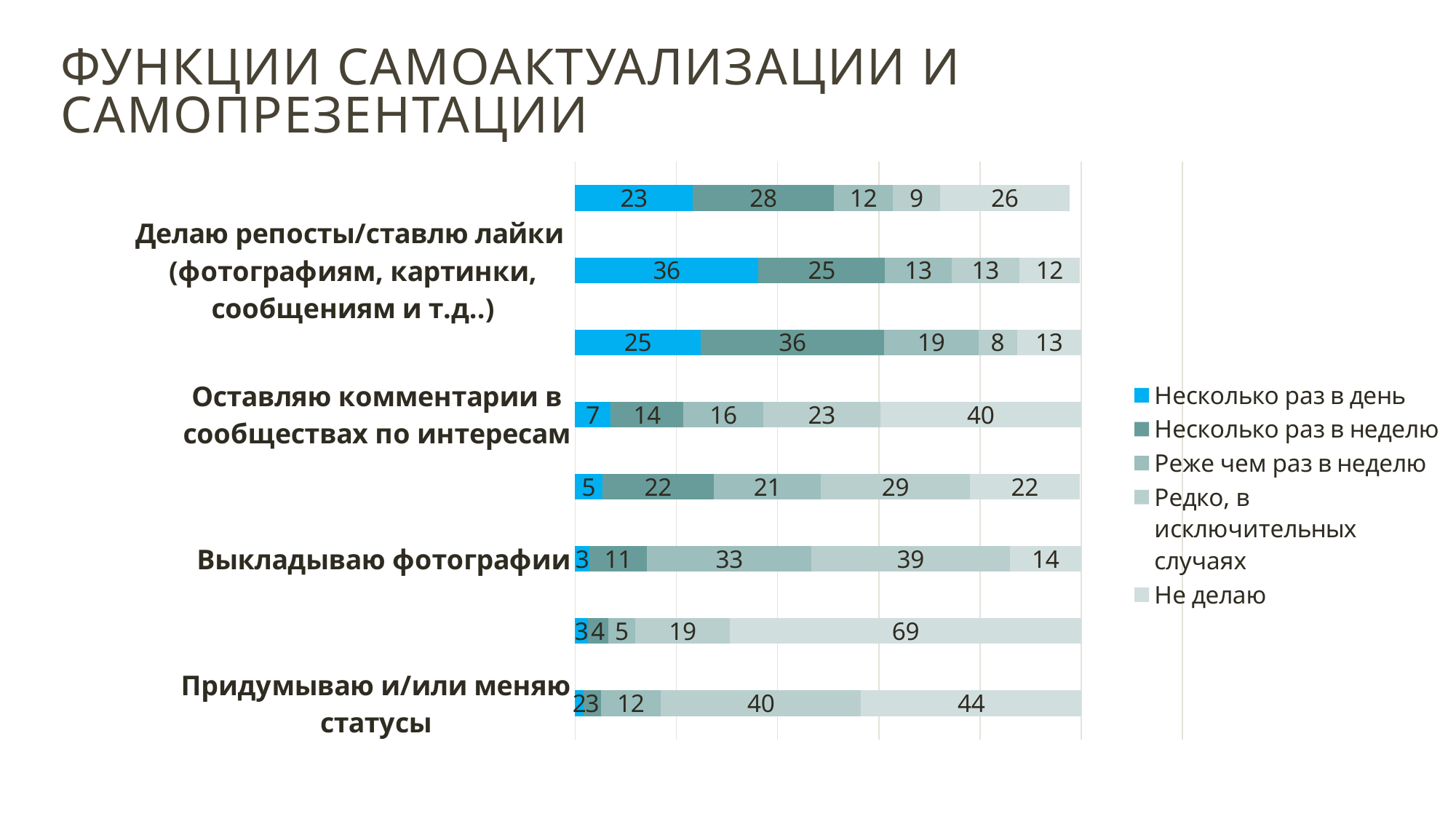
How many bars are plotted in the chart? 8 In the lower bar for "Выкладываю фотографии", what is the value for "Редко, в исключительных случаях"? 39 In the lower bar for "Оставляю комментарии в сообществах по интересам", which is larger: "Не делаю" or "Редко, в исключительных случаях"? Не делаю What is the total of the upper bar for "Придумываю и/или меняю статусы"? 100 In the topmost bar (upper bar for "Делаю репосты/ставлю лайки"), what is the value for "Не делаю"? 26 How many series does the legend list? 5 In the lower bar for "Делаю репосты/ставлю лайки", what is the difference between "Несколько раз в день" and "Не делаю"? 24 In the lower bar for "Выкладываю фотографии", which series has the smallest segment? Несколько раз в день In the upper bar for "Оставляю комментарии в сообществах по интересам", what is the value for "Несколько раз в неделю"? 36 What is the first entry in the legend? Несколько раз в день What kind of chart is shown on the slide? bar chart In the upper bar for "Придумываю и/или меняю статусы", which series has the largest segment? Не делаю